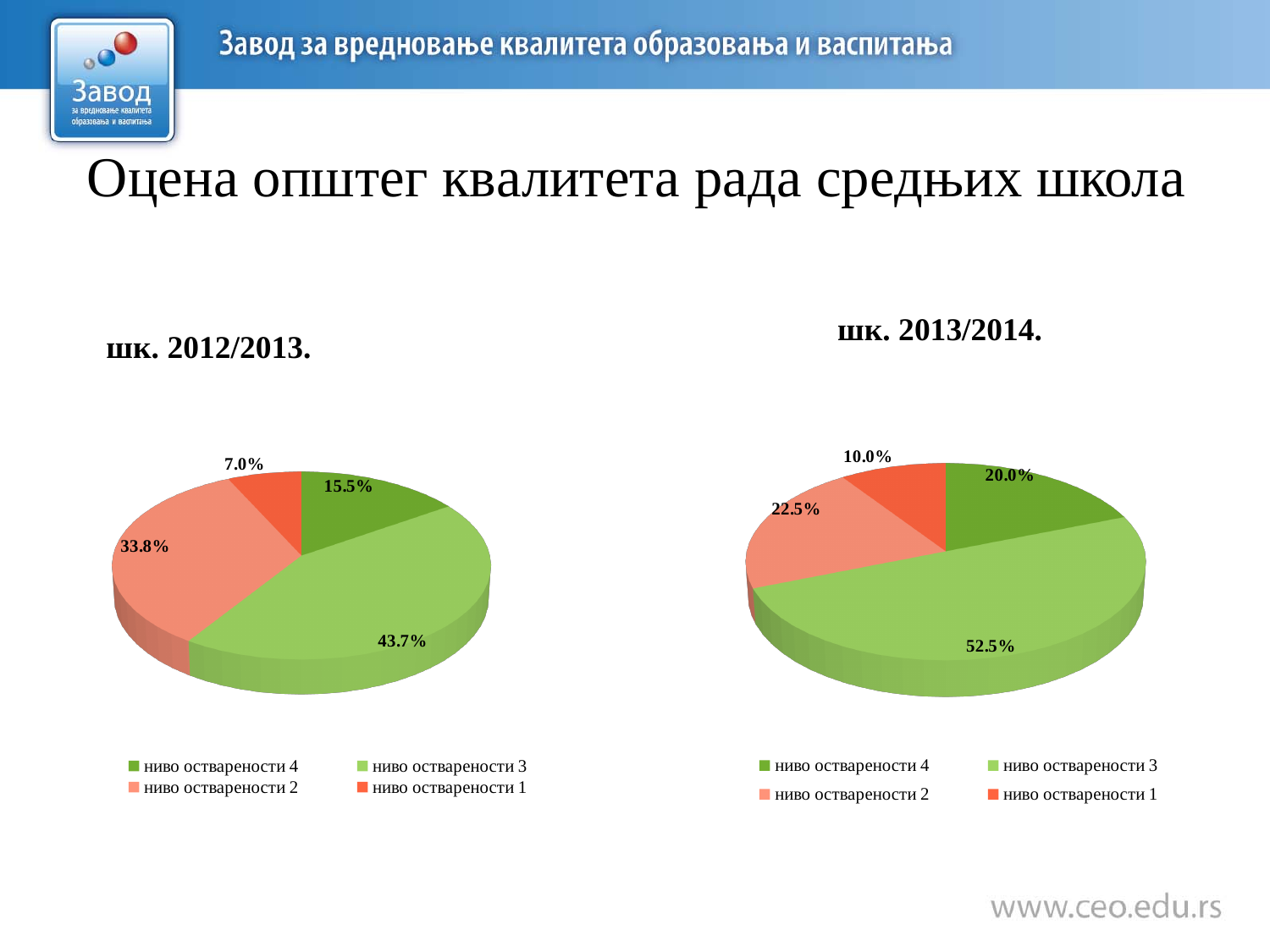
In the pie chart titled "шк. 2012/2013.", what share is labelled for "ниво остварености 2"? 33.8% In the pie chart titled "шк. 2013/2014.", which category has the largest slice? ниво остварености 3 How many slices does the pie chart titled "шк. 2013/2014." have? 4 Which is larger in the pie chart titled "шк. 2012/2013.": the share for "ниво остварености 4" or for "ниво остварености 2"? ниво остварености 2 In the pie chart titled "шк. 2013/2014.", what share is labelled for "ниво остварености 1"? 10.0% In the pie chart titled "шк. 2013/2014.", what colour is the slice for "ниво остварености 1"? Red-orange In the pie chart titled "шк. 2012/2013.", what share is labelled for "ниво остварености 3"? 43.7% What kind of chart is the chart titled "шк. 2012/2013."? Pie chart In the pie chart titled "шк. 2013/2014.", what is the difference between the shares for "ниво остварености 2" and "ниво остварености 4"? 2.5% In the pie chart titled "шк. 2012/2013.", what is the difference between the shares for "ниво остварености 3" and "ниво остварености 2"? 9.9% In the pie chart titled "шк. 2013/2014.", what share is labelled for "ниво остварености 4"? 20.0% In the pie chart titled "шк. 2012/2013.", which category has the smallest slice? ниво остварености 1